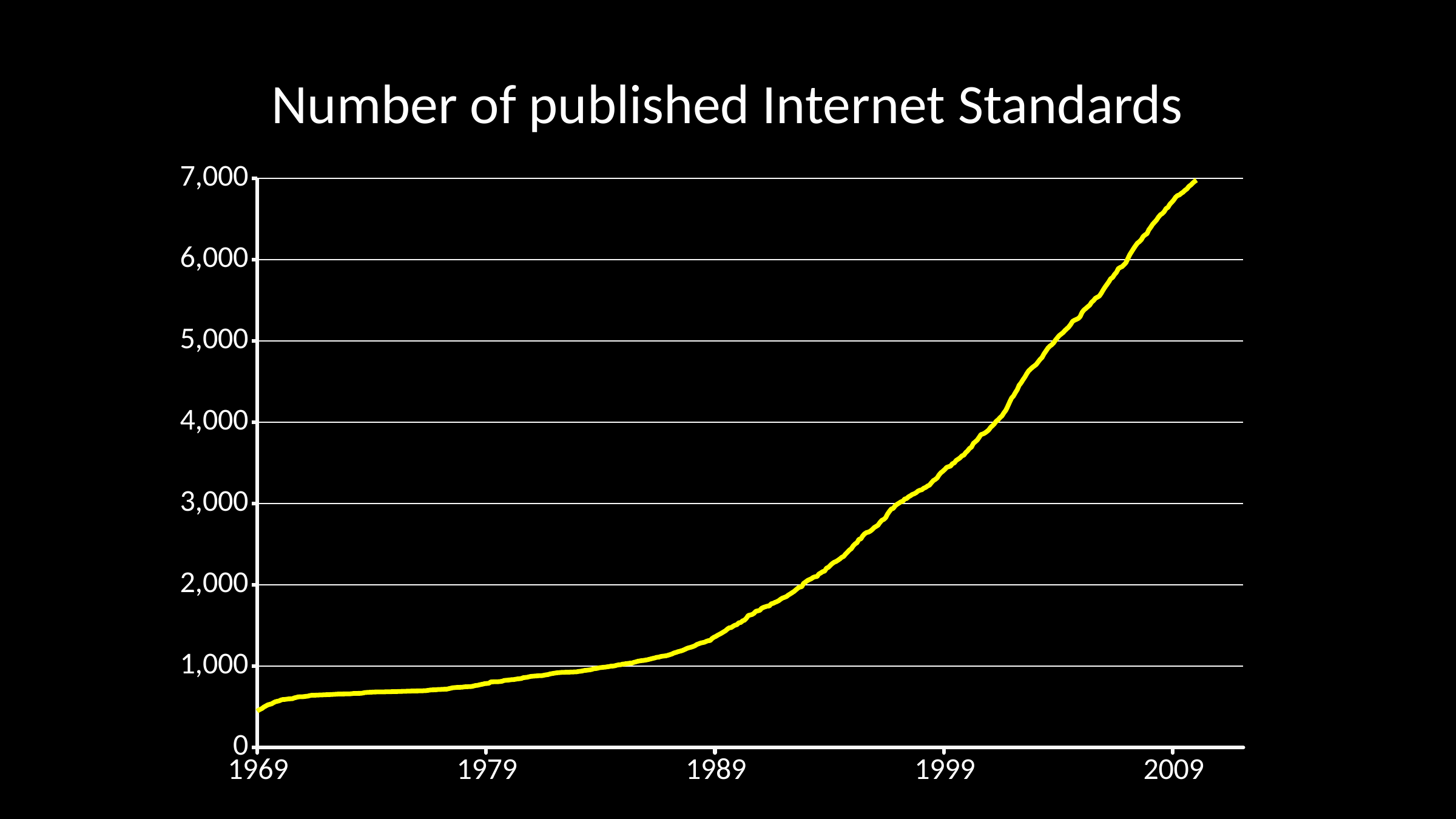
Is the value for 1969 greater or less than 1,000? less What is the title of the chart? Number of published Internet Standards Which year shown on the x axis has the higher value, 1979 or 1999? 1999 What kind of chart is shown on the slide? line chart Is the value for 2009 greater or less than 6,000? greater Do the values rise or fall from 1969 to 2009? rise Is the value for 1979 greater or less than 1,000? less Which year labelled on the x axis has the lowest value? 1969 What is the highest value shown on the y axis? 7,000